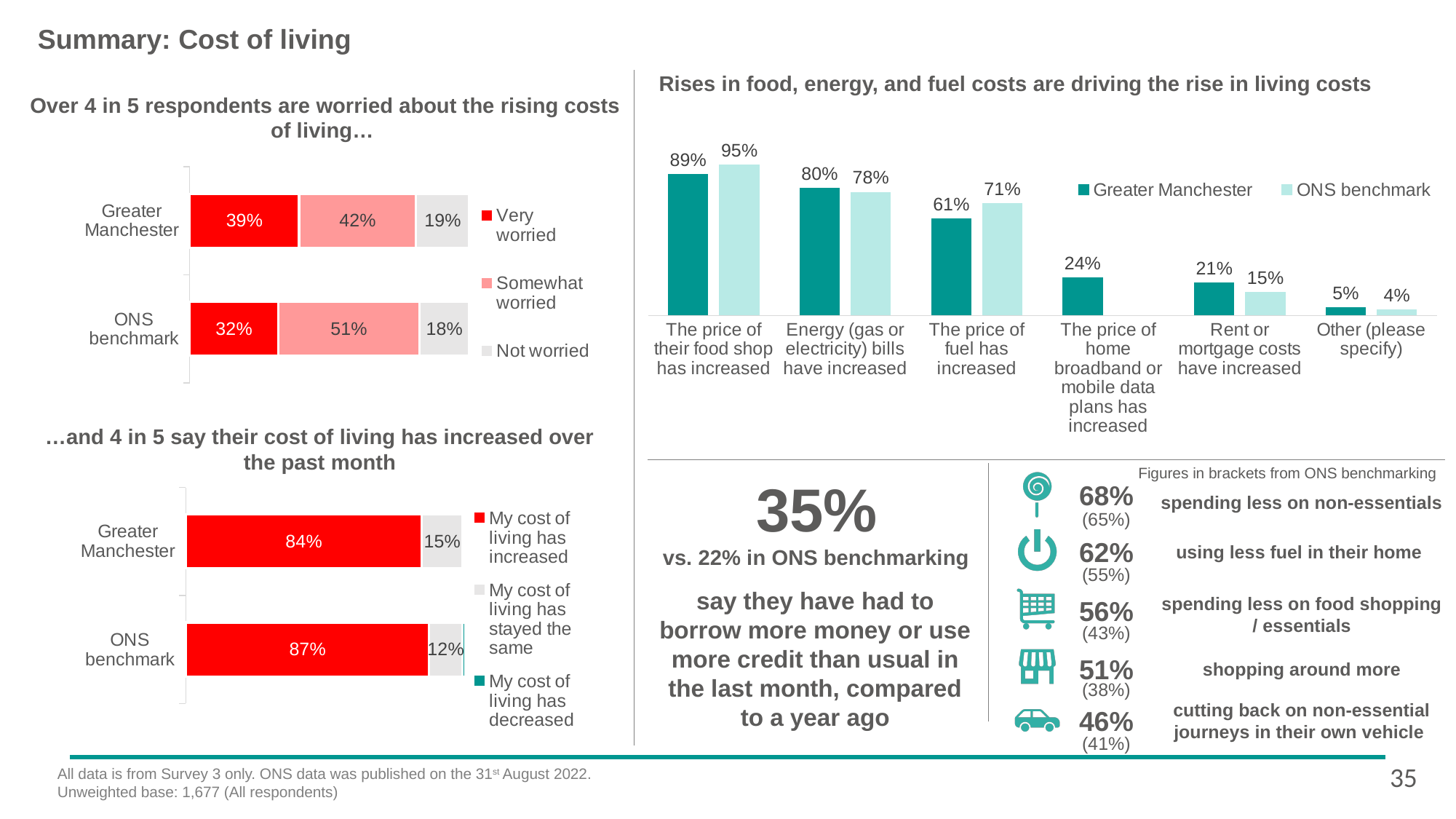
In the chart titled "Rises in food, energy, and fuel costs are driving the rise in living costs", how many categories are shown on the x axis? 6 In the chart titled "Over 4 in 5 respondents are worried about the rising costs of living…", what is the total of the three segments in the Greater Manchester bar? 100% In the chart titled "Rises in food, energy, and fuel costs are driving the rise in living costs", which category has the lowest ONS benchmark value? Other (please specify) In the chart titled "…and 4 in 5 say their cost of living has increased over the past month", what is the ONS benchmark value for "My cost of living has increased"? 87% In the chart titled "Rises in food, energy, and fuel costs are driving the rise in living costs", what is the ONS benchmark value for "Energy (gas or electricity) bills have increased"? 78% In the chart titled "Rises in food, energy, and fuel costs are driving the rise in living costs", what is the Greater Manchester value for "The price of fuel has increased"? 61% In the chart titled "Over 4 in 5 respondents are worried about the rising costs of living…", what percentage of the ONS benchmark is "Somewhat worried"? 51% In the chart titled "Rises in food, energy, and fuel costs are driving the rise in living costs", how many series does the legend list? 2 In the chart titled "Rises in food, energy, and fuel costs are driving the rise in living costs", how much higher is the ONS benchmark than Greater Manchester for "The price of their food shop has increased"? 6 percentage points What kind of chart is the chart titled "…and 4 in 5 say their cost of living has increased over the past month"? Stacked bar chart In the chart titled "Rises in food, energy, and fuel costs are driving the rise in living costs", for "Rent or mortgage costs have increased", which is larger: Greater Manchester or ONS benchmark? Greater Manchester In the chart titled "Rises in food, energy, and fuel costs are driving the rise in living costs", which category has the highest Greater Manchester value? The price of their food shop has increased